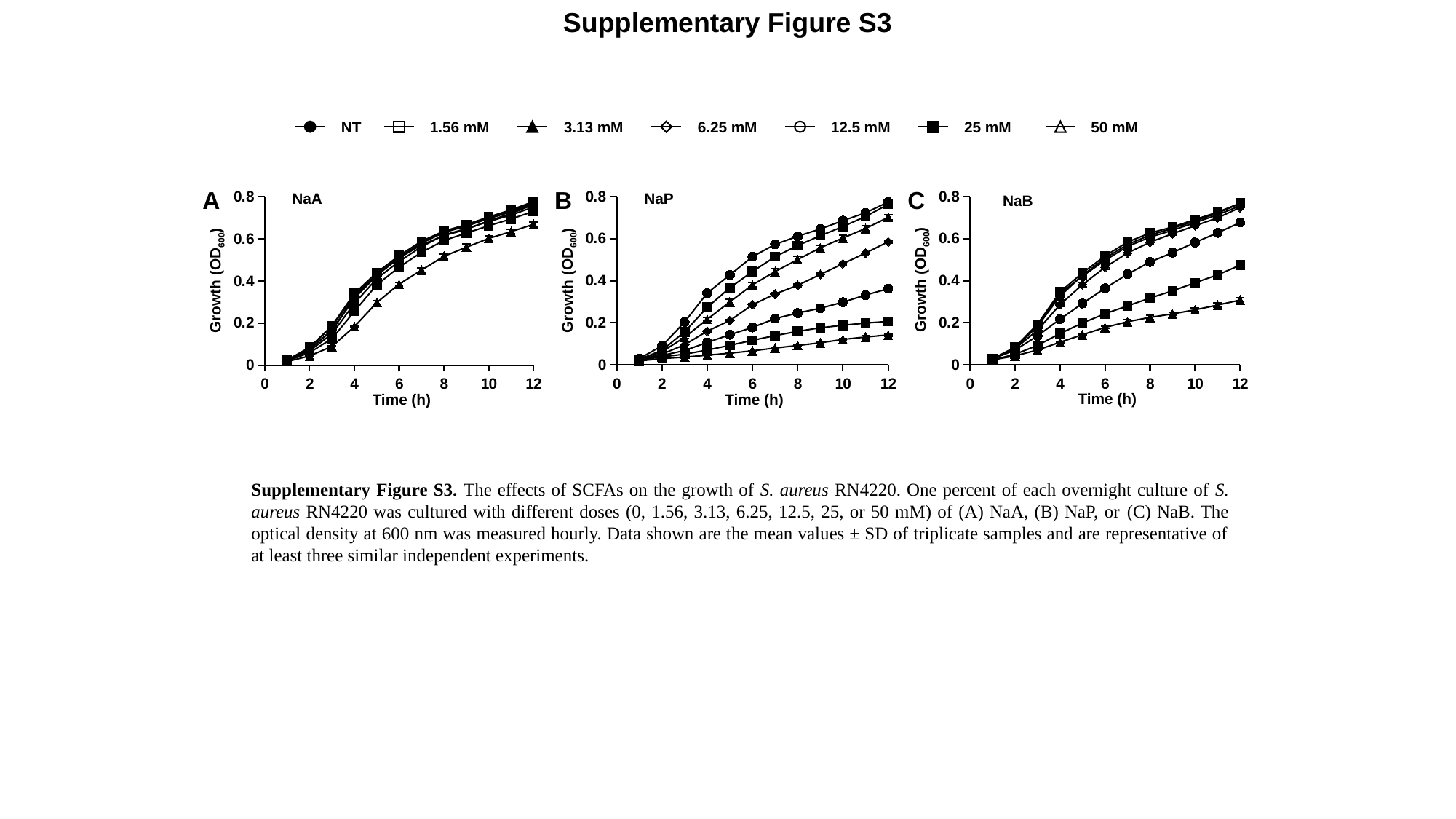
In the NaA chart, is the value of the lowest curve at 12 h greater or less than 0.6? greater In the NaA chart, do the growth values rise or fall as time increases? Rise What is the y-axis label on the NaP chart? Growth (OD600) How many series does the shared legend list? 7 What kind of chart is panel A (NaA)? Line chart What are the legend entries for the charts? NT, 1.56 mM, 3.13 mM, 6.25 mM, 12.5 mM, 25 mM, 50 mM In the NaB chart, is the value of the lowest curve at 12 h greater or less than 0.4? less In the NaB chart, is the value of the lowest curve at 12 h greater or less than 0.2? greater What is the highest tick value shown on the y-axis of the NaA chart? 0.8 How many time points are plotted for each series in the NaB chart? 12